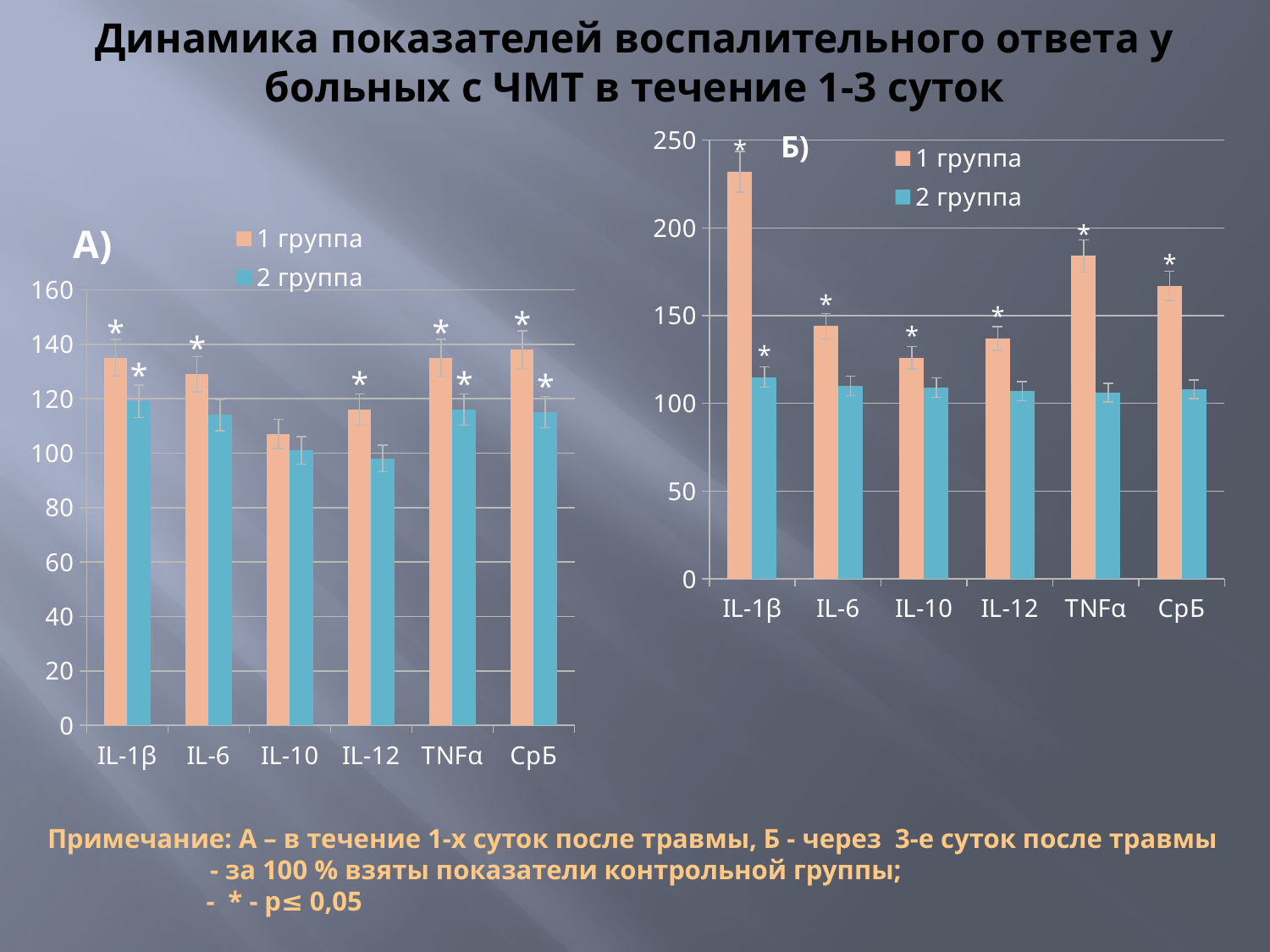
In chart Б), is the value for 1 группа at СрБ greater or less than 150? greater In chart А), which category has the lowest value for 1 группа? IL-10 In chart Б), which category has the highest value for 1 группа? IL-1β In chart А), is the value for 1 группа at IL-1β greater or less than 120? greater In chart Б), which is larger at IL-1β: 1 группа or 2 группа? 1 группа In chart А), which is larger at IL-12: 1 группа or 2 группа? 1 группа How many series does the legend of chart А) list? 2 In chart Б), is the value for 1 группа at TNFα greater or less than 200? less What kind of chart is chart А) on the left? bar chart How many categories are shown on the x axis of chart Б) on the right? 6 What are the two legend entries of chart Б)? 1 группа, 2 группа